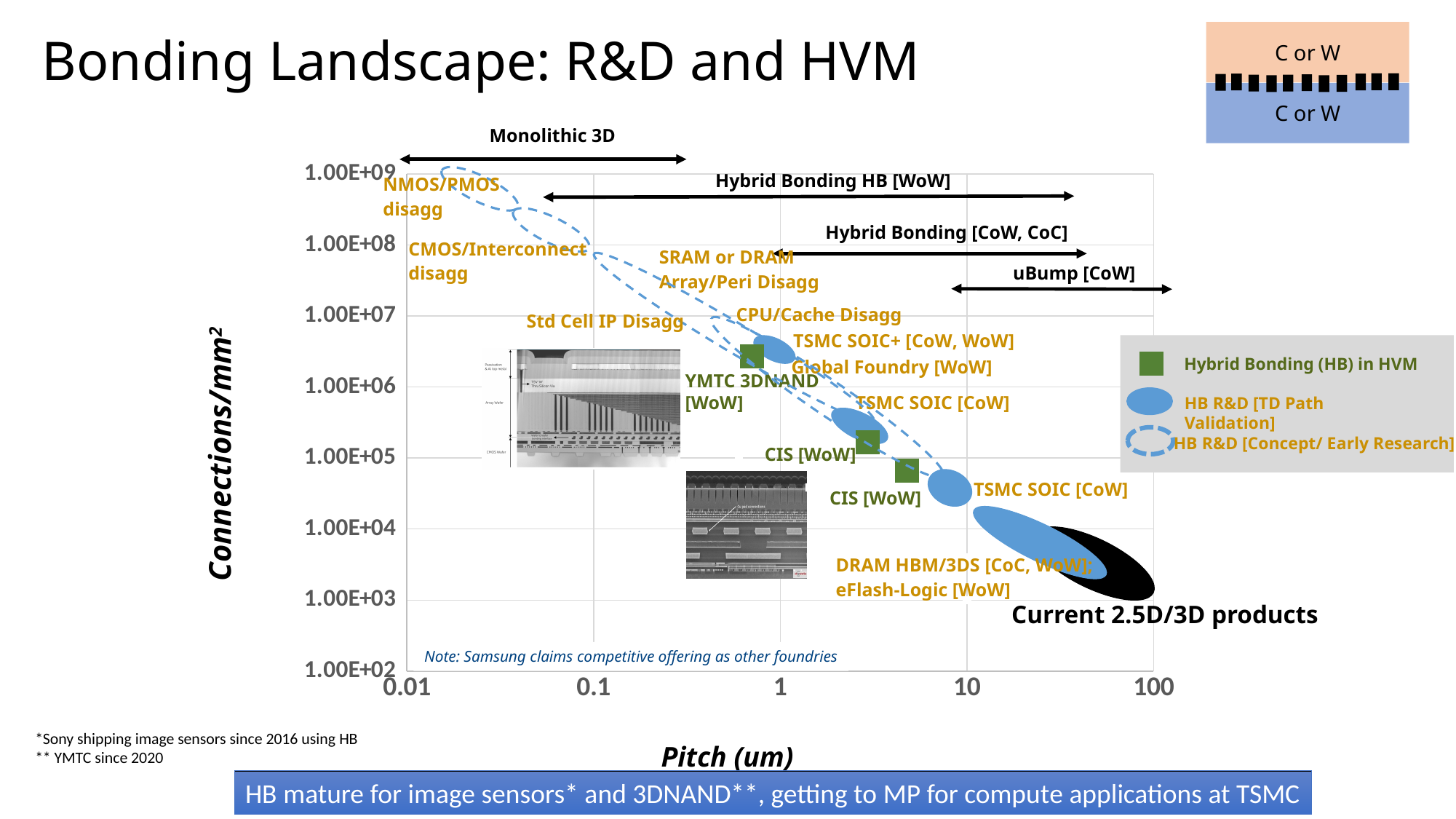
Which labeled item on the chart has the lowest connections/mm²? Current 2.5D/3D products How many green squares (Hybrid Bonding in HVM points) are plotted on the chart? 3 How many entries does the legend list? 3 As pitch increases along the x axis, do the plotted connections/mm² values rise or fall? Fall Is the pitch for Current 2.5D/3D products greater or less than 10 um? greater What is the label of the y axis? Connections/mm² What kind of chart is shown on the slide? Scatter (bubble) chart Is the connections/mm² value for YMTC 3DNAND [WoW] greater or less than 1.00E+06? greater Is the pitch for NMOS/PMOS disagg greater or less than 0.1 um? less Which labeled item on the chart has the highest connections/mm²? NMOS/PMOS disagg Which has the higher connections/mm²: YMTC 3DNAND [WoW] or CIS [WoW]? YMTC 3DNAND [WoW] What is the label of the x axis? Pitch (um)